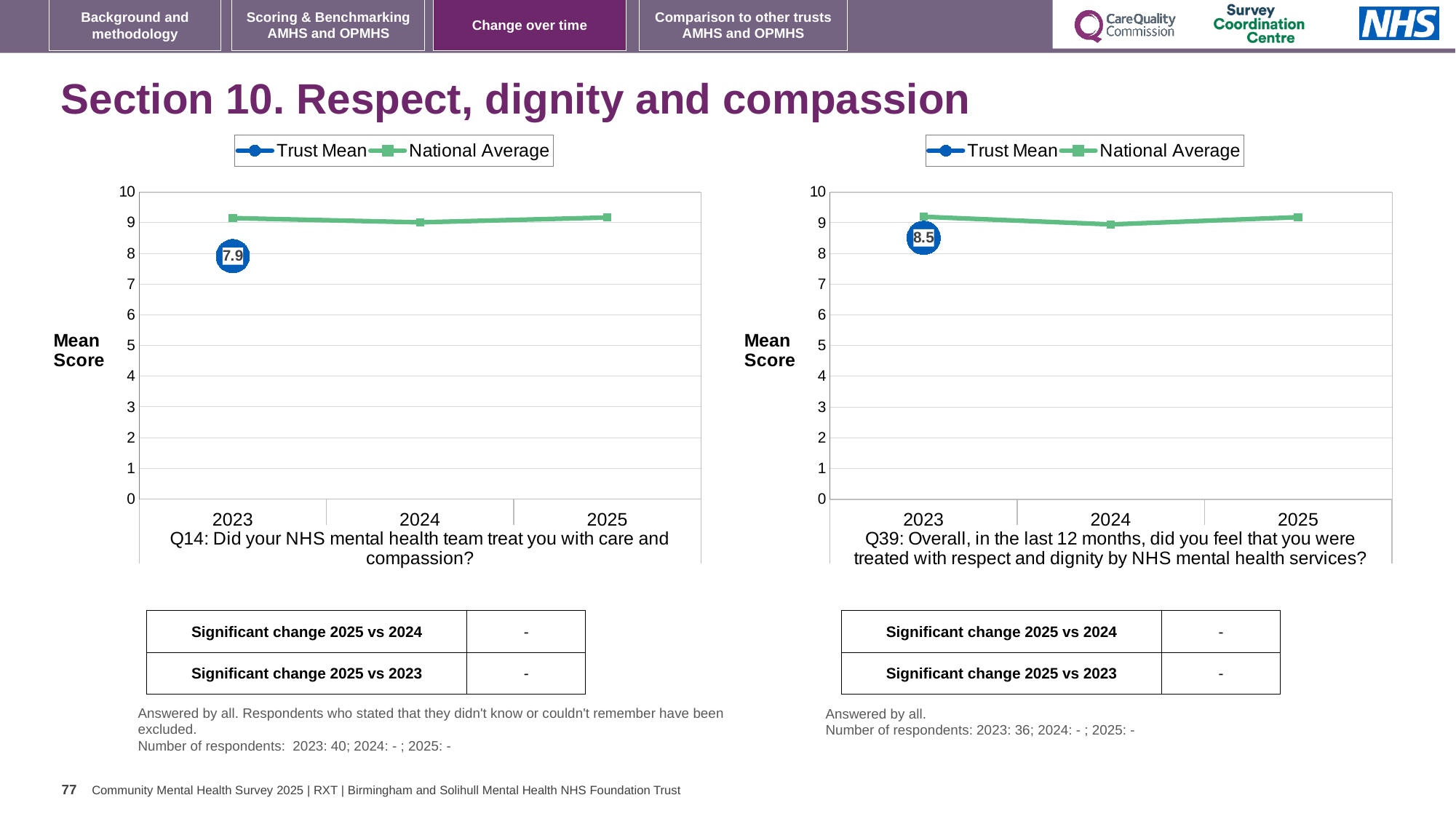
Which of the two Trust Mean values for 2023 is higher: the left chart (Q14) or the right chart (Q39)? Right chart (Q39) In the left chart (Q14), is the National Average value for 2024 greater or less than 8? greater What are the two legend entries in the left chart (Q14)? Trust Mean and National Average In the left chart (Q14), which is higher in 2023: the Trust Mean or the National Average? National Average In the right chart (Q39), what is the Trust Mean value for 2023? 8.5 What is the y-axis label of the right chart (Q39)? Mean Score In the left chart (Q14), what is the Trust Mean value for 2023? 7.9 In the right chart (Q39), which is higher in 2023: the Trust Mean or the National Average? National Average In the right chart (Q39), is the National Average value for 2025 greater or less than 8? greater What kind of chart is the left chart (Q14)? Line chart How many years are shown on the x axis of the left chart (Q14)? 3 How many series does the legend of the right chart (Q39) list? 2